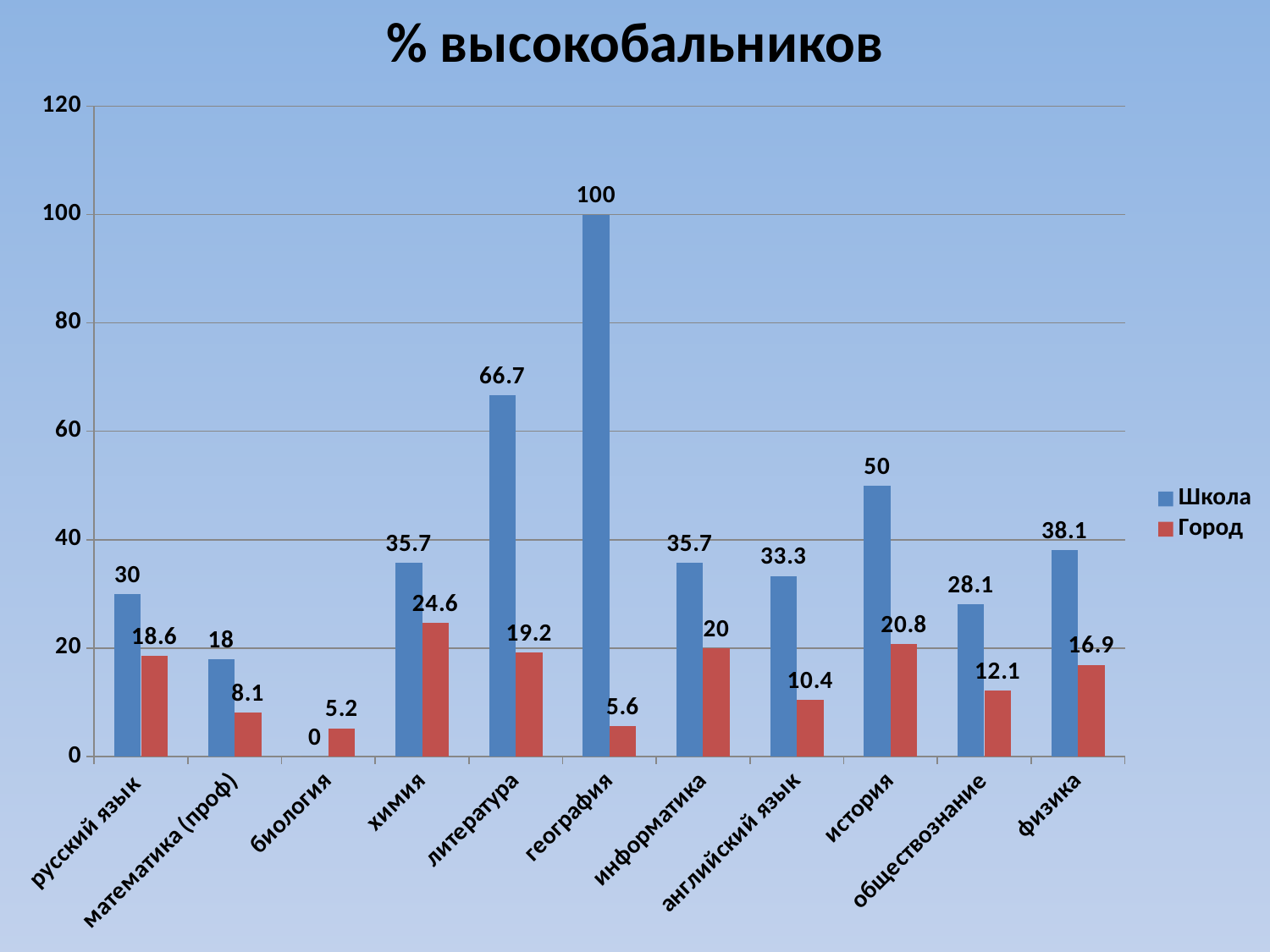
What kind of chart is shown on the slide? bar chart How many series does the legend list? 2 How many categories are shown on the x axis? 11 What is the title of the chart? % высокобальников Which category has the highest Школа value? география Which is larger: the Город value for литература or the Город value for информатика? информатика What is the difference between the Школа and Город values for история? 29.2 What is the Школа value for география? 100 What is the Город value for химия? 24.6 What is the Школа value for биология? 0 Which series is shown in red? Город Which category has the lowest Город value? биология